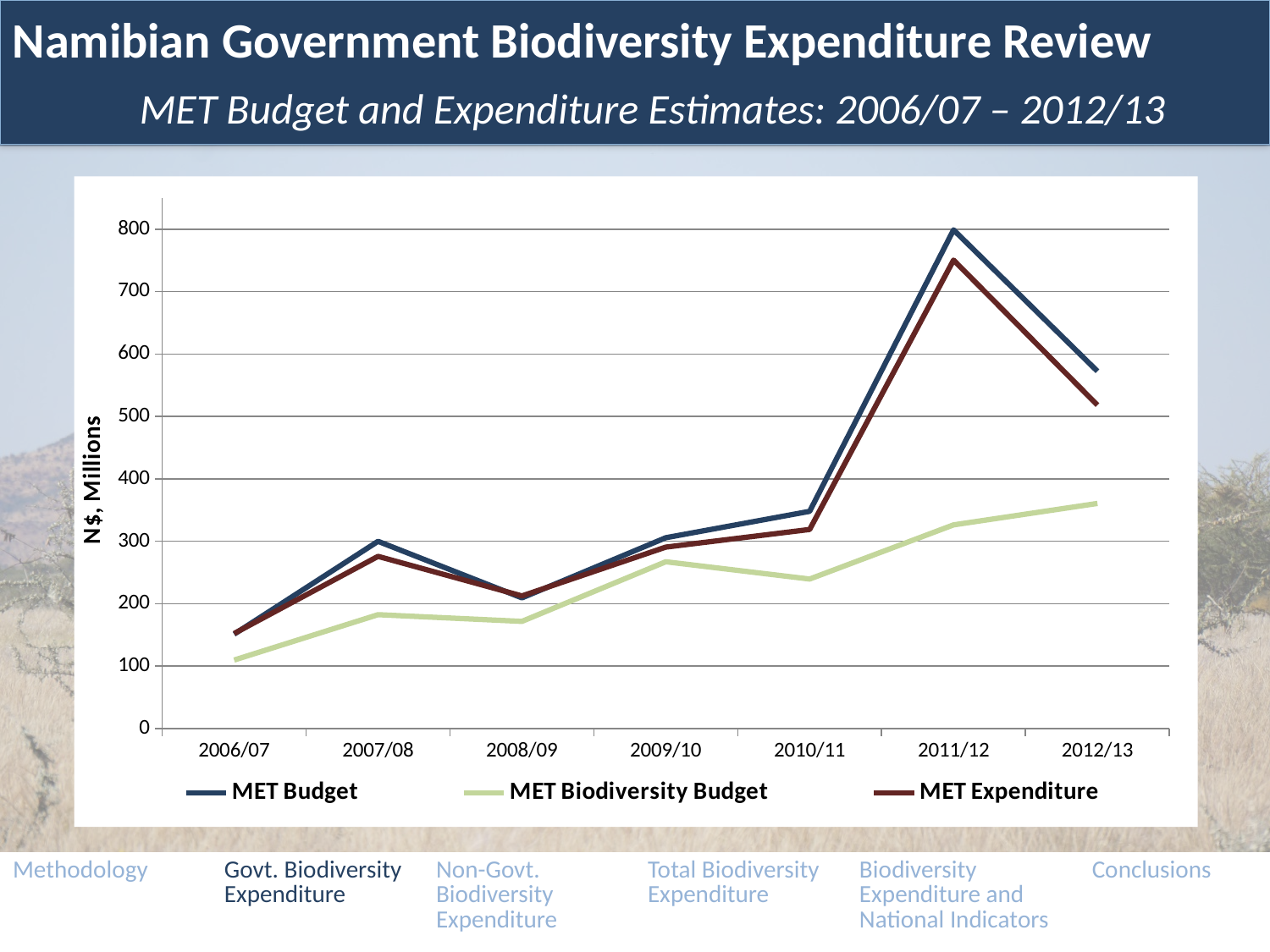
How many fiscal years are shown on the x axis? 7 Is the MET Biodiversity Budget value for 2012/13 greater or less than 300? greater Is the MET Budget value for 2011/12 greater or less than 700? greater Does the MET Budget rise or fall from 2011/12 to 2012/13? Fall What kind of chart is shown on the slide? Line chart In which year is the MET Budget highest? 2011/12 Does the MET Biodiversity Budget rise or fall from 2010/11 to 2012/13? Rise In which year is the MET Biodiversity Budget lowest? 2006/07 Which is larger in 2011/12, the MET Budget or the MET Expenditure? MET Budget Is the MET Expenditure value for 2006/07 greater or less than 200? less How many series does the legend list? 3 What is the label on the y axis of the chart? N$, Millions